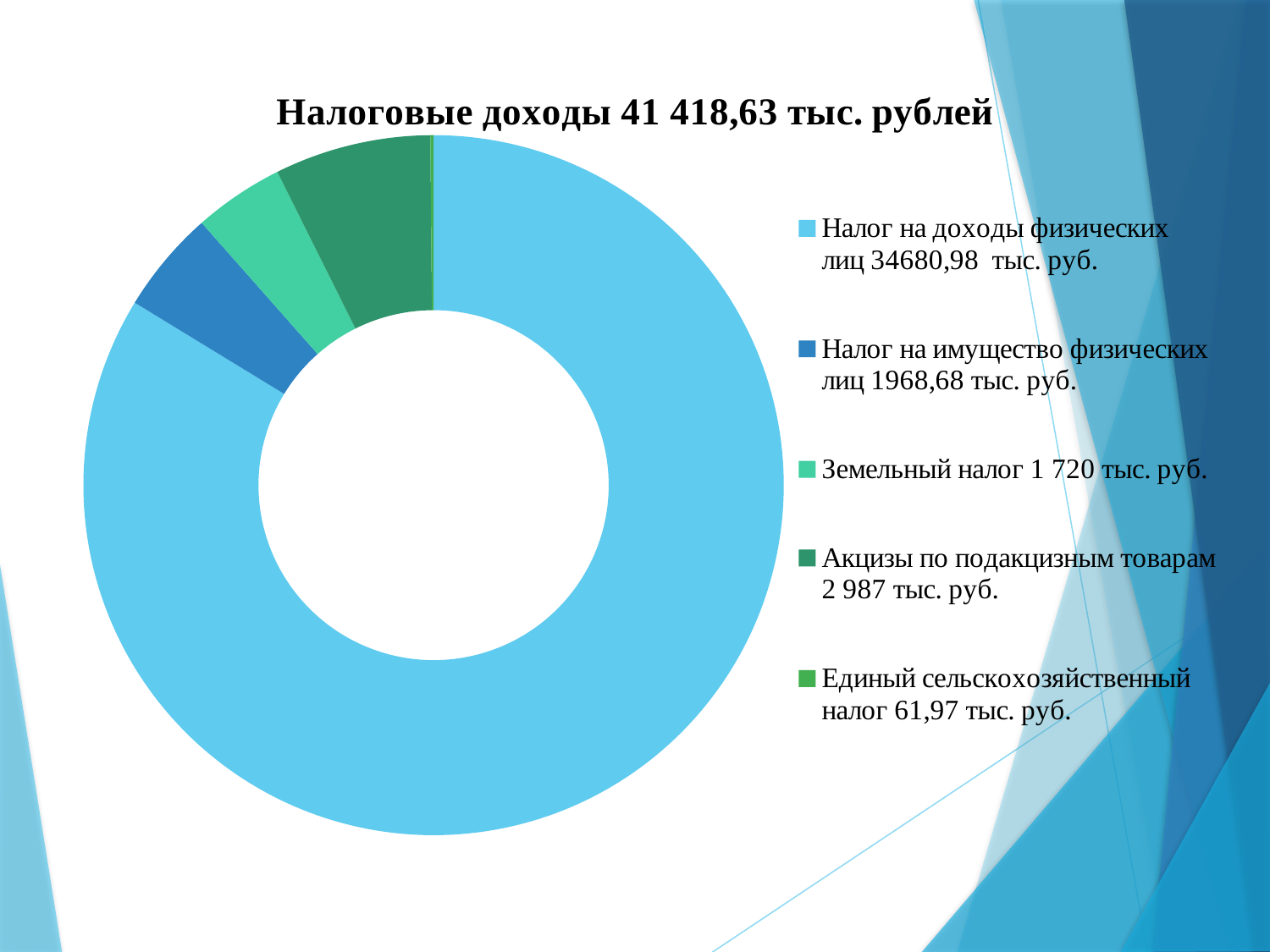
How many categories does the chart legend list? 5 What is the value for Земельный налог? 1 720 тыс. руб. What is the difference between Акцизы по подакцизным товарам and Земельный налог? 1 267 тыс. руб. Which is larger: Акцизы по подакцизным товарам or Земельный налог? Акцизы по подакцизным товарам What is the value for Налог на доходы физических лиц? 34680,98 тыс. руб. Which category has the largest share of the chart? Налог на доходы физических лиц What type of chart is shown on the slide? doughnut chart What is the value for Акцизы по подакцизным товарам? 2 987 тыс. руб. What is the value for Налог на имущество физических лиц? 1968,68 тыс. руб. What is the title of the chart? Налоговые доходы 41 418,63 тыс. рублей Which category has the smallest share of the chart? Единый сельскохозяйственный налог What is the value for Единый сельскохозяйственный налог? 61,97 тыс. руб.